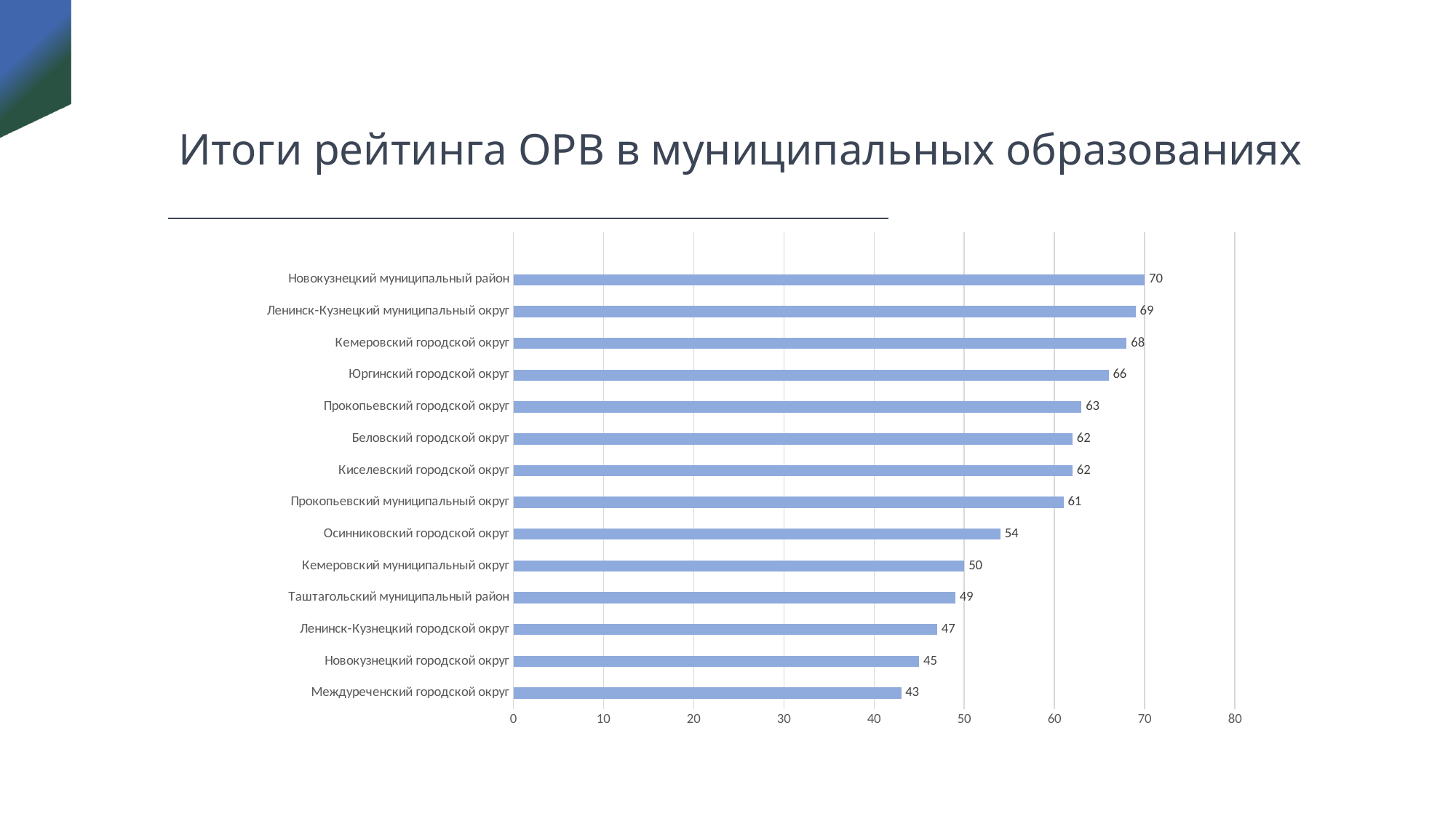
What is the value for Кемеровский городской округ? 68 What kind of chart is shown on the slide? bar chart Which category has the lowest value? Междуреченский городской округ What is the value for Междуреченский городской округ? 43 What is the difference between the values for Новокузнецкий муниципальный район and Междуреченский городской округ? 27 What is the title of the slide? Итоги рейтинга ОРВ в муниципальных образованиях Which is larger, the value for Прокопьевский городской округ or the value for Кемеровский муниципальный округ? Прокопьевский городской округ What is the value for Осинниковский городской округ? 54 Is the value for Ленинск-Кузнецкий городской округ greater or less than 50? less How many categories are shown in the chart? 14 What is the difference between the values for Юргинский городской округ and Таштагольский муниципальный район? 17 Which category has the highest value? Новокузнецкий муниципальный район